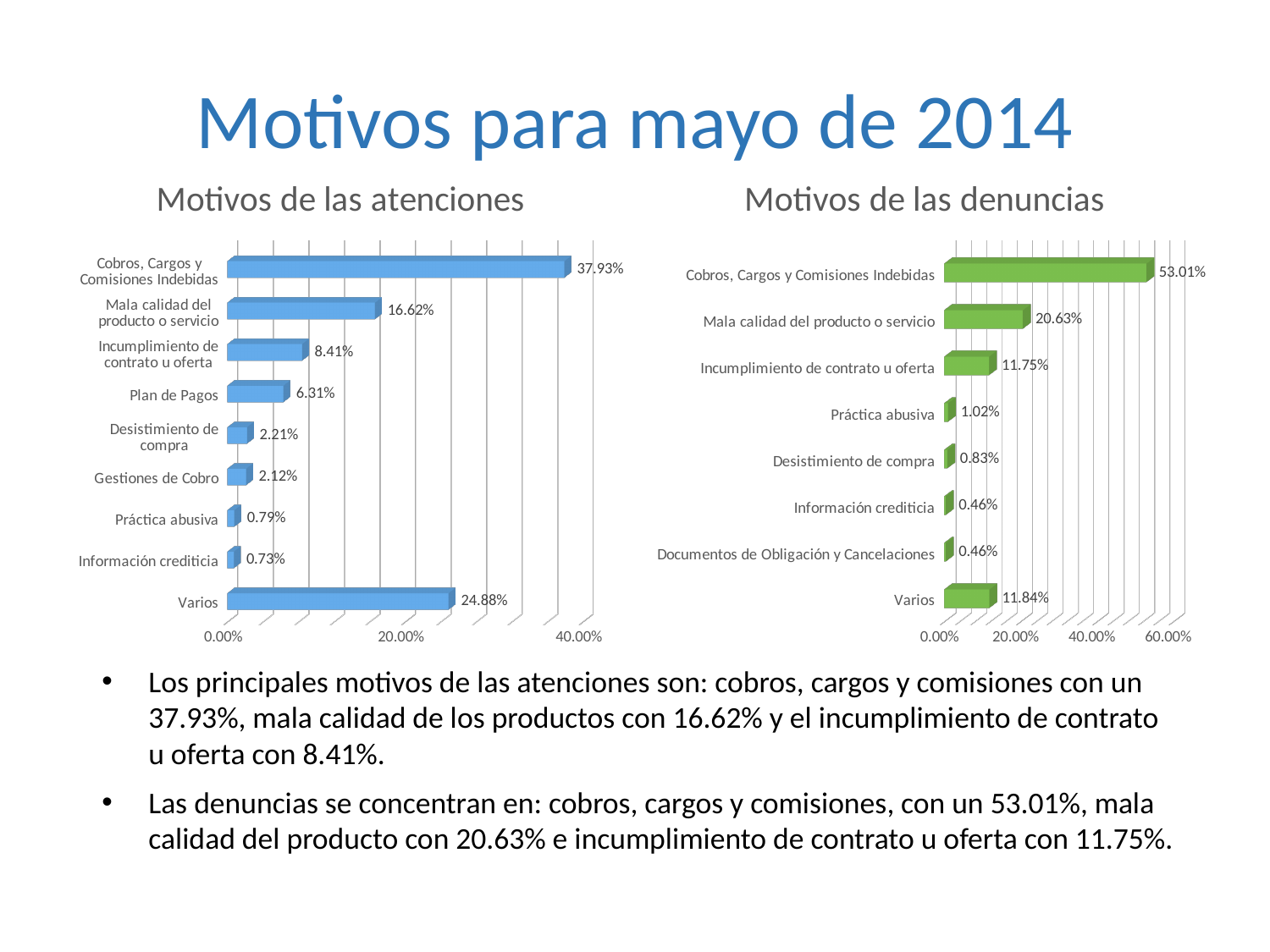
In the 'Motivos de las atenciones' chart, what is the value for Cobros, Cargos y Comisiones Indebidas? 37.93% In the 'Motivos de las denuncias' chart, what is the value for Varios? 11.84% How many categories are shown in the 'Motivos de las denuncias' chart? 8 In the 'Motivos de las denuncias' chart, what is the value for Mala calidad del producto o servicio? 20.63% In the 'Motivos de las atenciones' chart, which category has the highest value? Cobros, Cargos y Comisiones Indebidas In the 'Motivos de las denuncias' chart, which category has the highest value? Cobros, Cargos y Comisiones Indebidas In the 'Motivos de las denuncias' chart, what is the difference between Cobros, Cargos y Comisiones Indebidas and Mala calidad del producto o servicio? 32.38% In the 'Motivos de las atenciones' chart, what is the difference between Cobros, Cargos y Comisiones Indebidas and Mala calidad del producto o servicio? 21.31% What kind of chart is 'Motivos de las denuncias'? Bar chart How many categories are shown in the 'Motivos de las atenciones' chart? 9 In the 'Motivos de las atenciones' chart, which is larger: Varios or Incumplimiento de contrato u oferta? Varios In the 'Motivos de las atenciones' chart, what is the value for Plan de Pagos? 6.31%